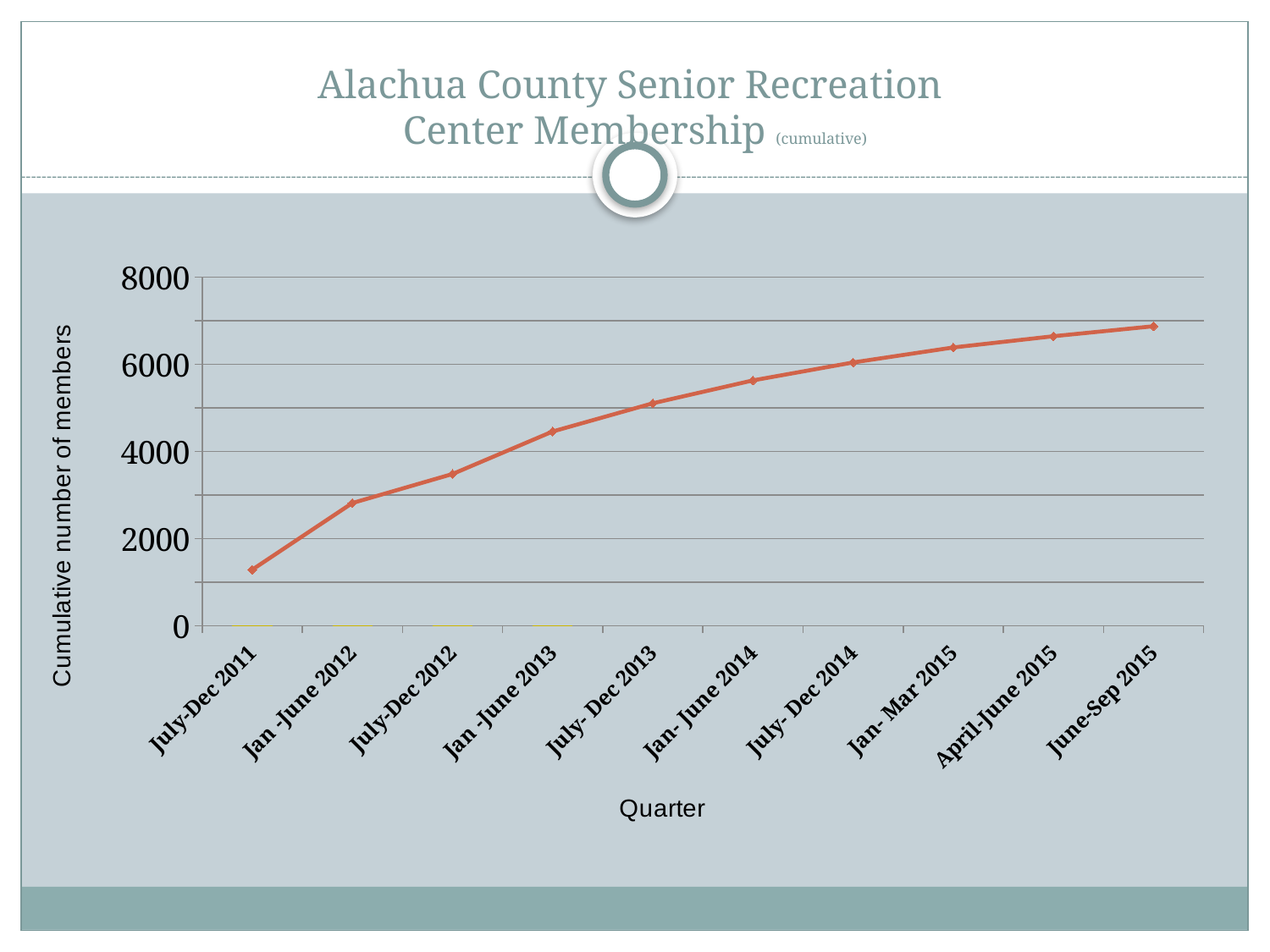
Which quarter has the lowest cumulative number of members? July-Dec 2011 Which quarter has the highest cumulative number of members? June-Sep 2015 What is the label of the vertical axis? Cumulative number of members How many quarters are plotted on the x axis? 10 Is the value for July-Dec 2011 greater or less than 2000? less What kind of chart is shown on the slide? Line chart Is the value for June-Sep 2015 greater or less than 8000? less Do the values rise or fall from July-Dec 2011 to June-Sep 2015? Rise Is the value for Jan-June 2012 greater or less than 2000? greater